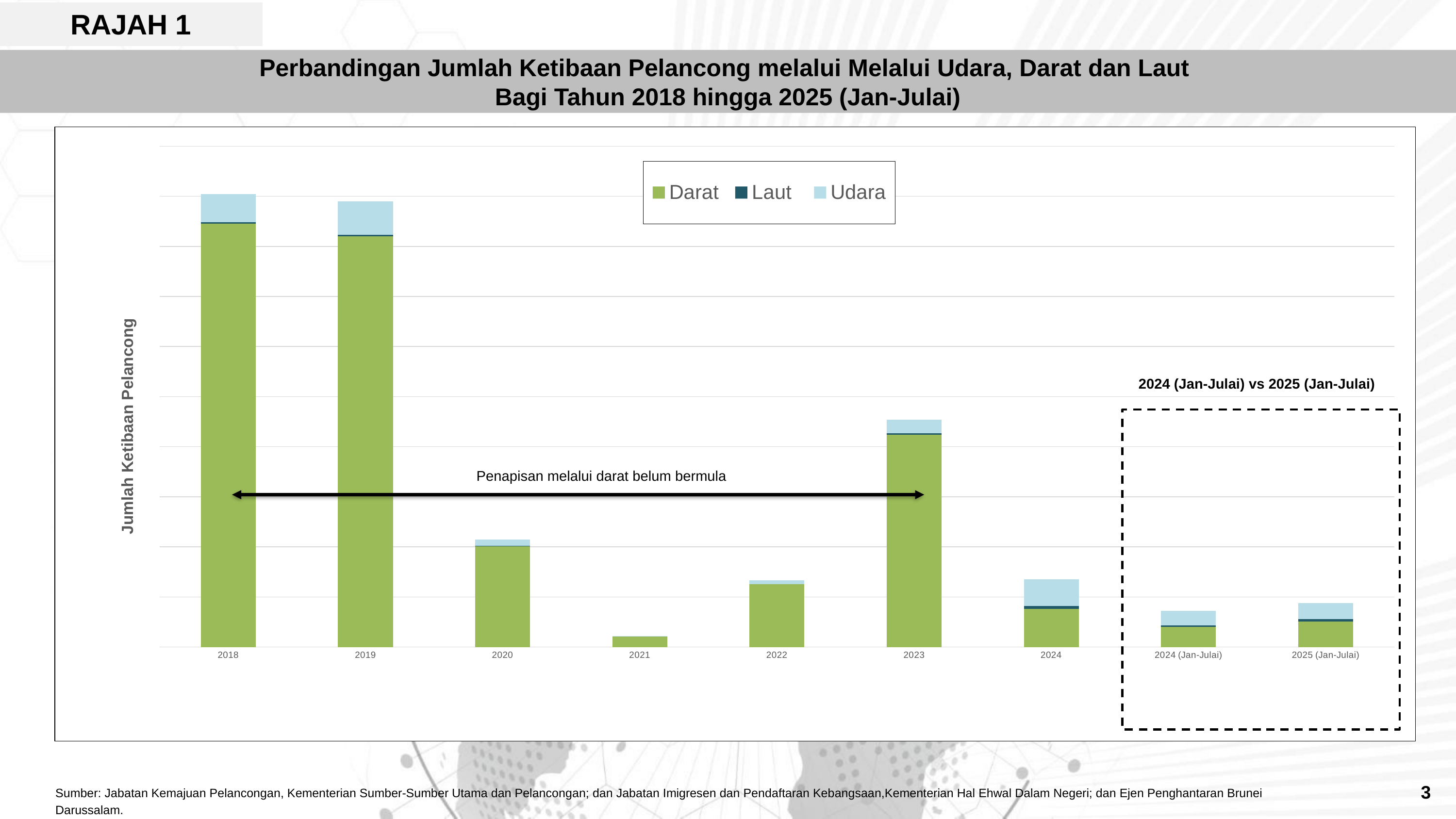
Which has the larger total bar, 2020 or 2022? 2020 Which has the larger total bar, 2023 or 2024? 2023 What are the three series named in the legend? Darat, Laut, Udara What kind of chart is shown on the slide? Stacked bar chart What is the label on the y axis? Jumlah Ketibaan Pelancong How many categories are shown along the x axis? 9 How many series does the legend list? 3 Do the total bars rise or fall from 2018 to 2021? Fall Do the total bars rise or fall from 2021 to 2023? Rise Which category has the lowest total bar? 2021 Which category has the highest total bar? 2018 Which has the larger total bar, 2019 or 2020? 2019